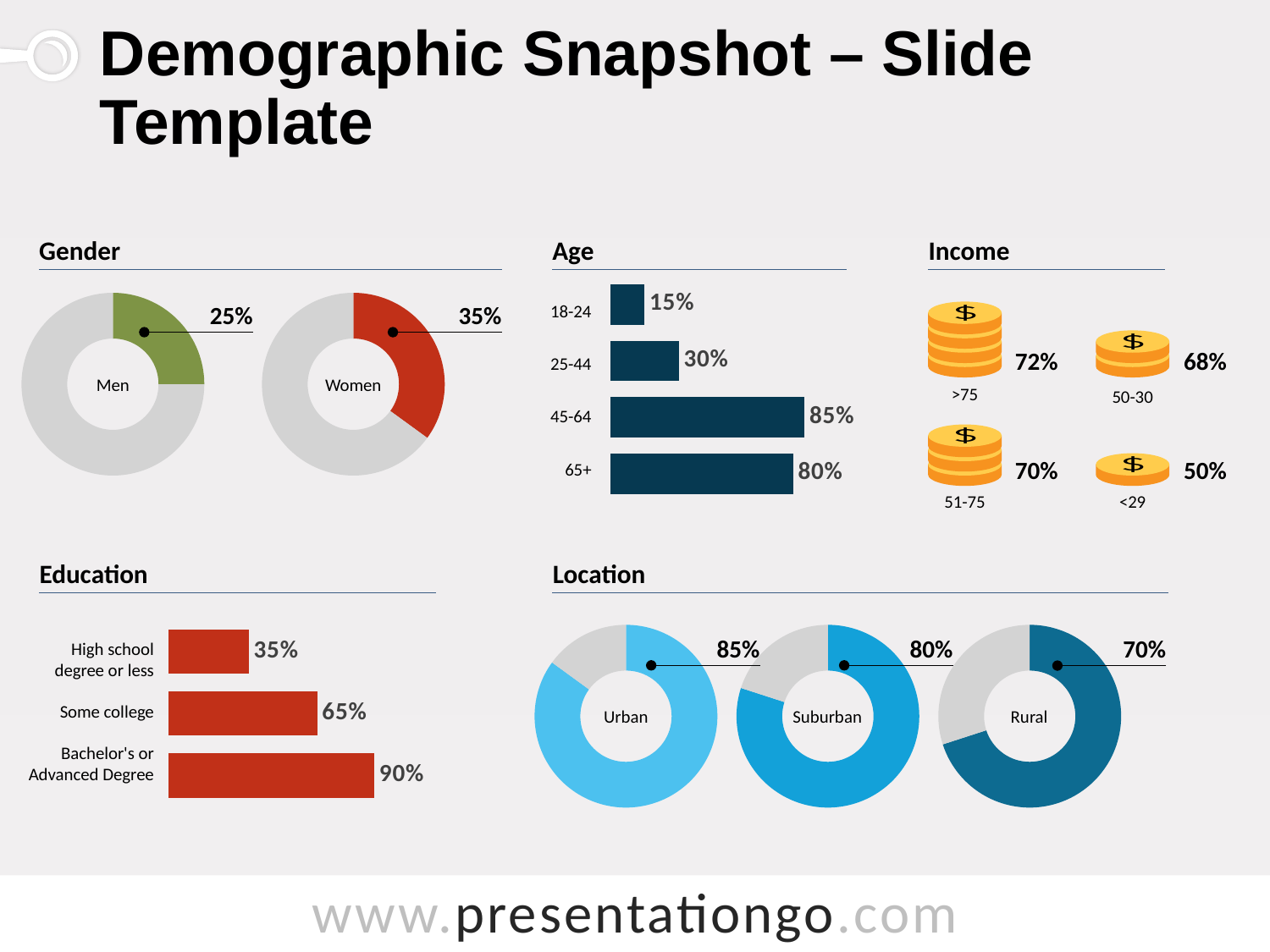
In the Gender chart, which is larger, the value for Men or the value for Women? Women In the Age chart, which age group has the lowest value? 18-24 How many age groups are shown in the Age chart? 4 What kind of chart is used for the Location section? Donut chart What kind of chart is the Education chart? Bar chart In the Location chart, what is the difference between the Urban and Rural values? 15% In the Location chart, what is the value for Rural? 70% In the Gender chart, what percentage is shown for Women? 35% In the Age chart, what is the difference between the 45-64 and 25-44 values? 55% In the Education chart, which category has the highest value? Bachelor's or Advanced Degree In the Age chart, what is the value for the 45-64 group? 85% In the Education chart, what is the value for Some college? 65%